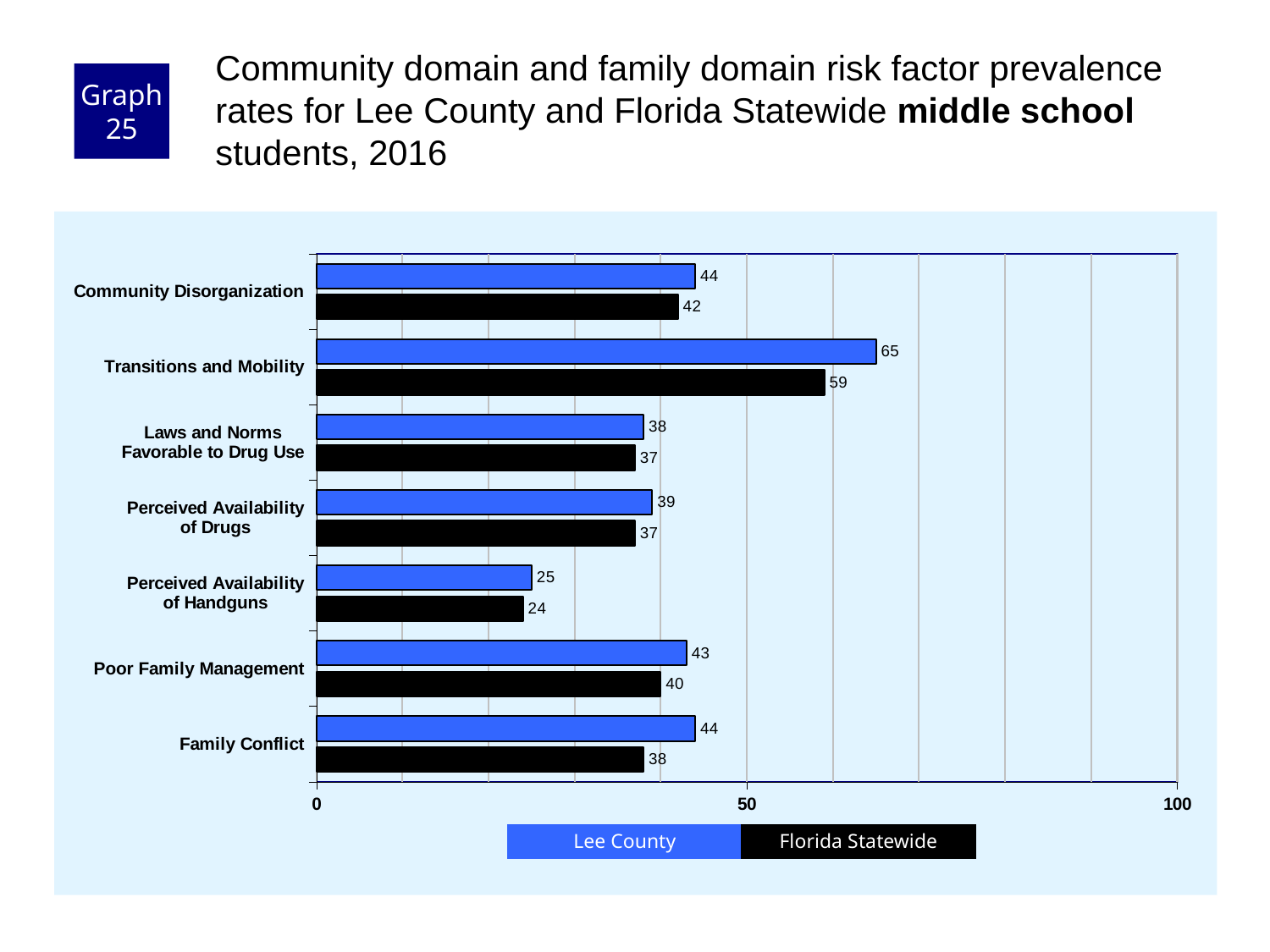
What is the Florida Statewide value for Family Conflict? 38 Is the Lee County value for Transitions and Mobility greater or less than 50? greater How many series does the legend list? 2 How many risk factor categories are shown on the chart? 7 Which is larger for Poor Family Management: the Lee County value or the Florida Statewide value? Lee County What is the difference between the Lee County and Florida Statewide values for Family Conflict? 6 What is the Lee County value for Transitions and Mobility? 65 What is the difference between the Lee County and Florida Statewide values for Transitions and Mobility? 6 What is the Florida Statewide value for Perceived Availability of Handguns? 24 What kind of chart is shown on the slide? Bar chart Which risk factor has the highest Lee County value? Transitions and Mobility Which risk factor has the lowest Florida Statewide value? Perceived Availability of Handguns